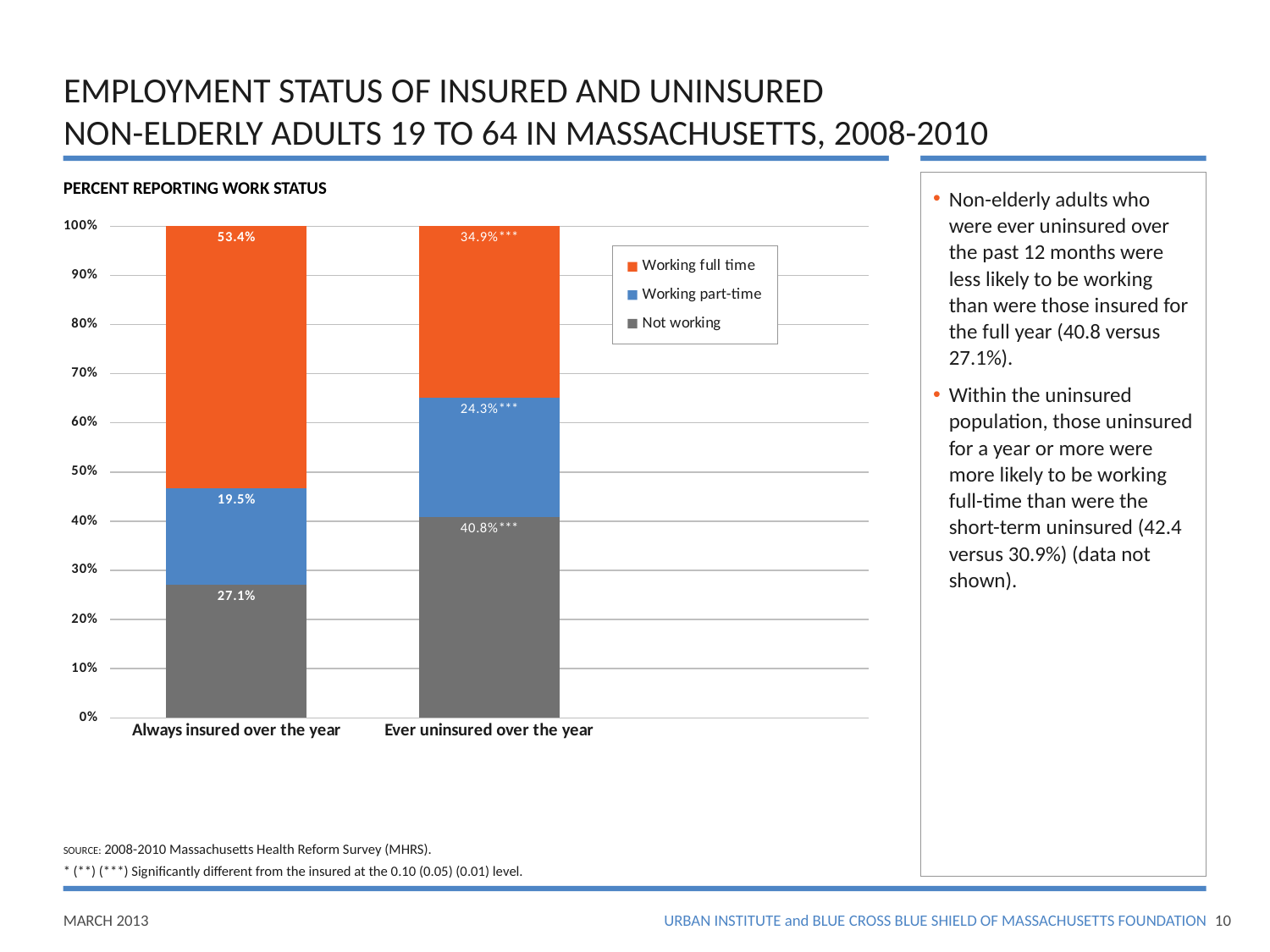
Which colour represents 'Not working' in the chart? Gray What percentage of adults always insured over the year were not working? 27.1% How many series does the legend list? 3 What kind of chart is shown on the slide? Stacked bar chart How many categories are shown on the x axis? 2 What is the difference in the not working share between ever uninsured and always insured adults? 13.7 percentage points What is the difference in the working full time share between always insured and ever uninsured adults? 18.5 percentage points What percentage of adults ever uninsured over the year were working part-time? 24.3% What percentage of adults ever uninsured over the year were not working? 40.8% What percentage of adults always insured over the year were working full time? 53.4% Which category has the higher share working full time, always insured or ever uninsured? Always insured over the year Which work status segment is the smallest for adults always insured over the year? Working part-time